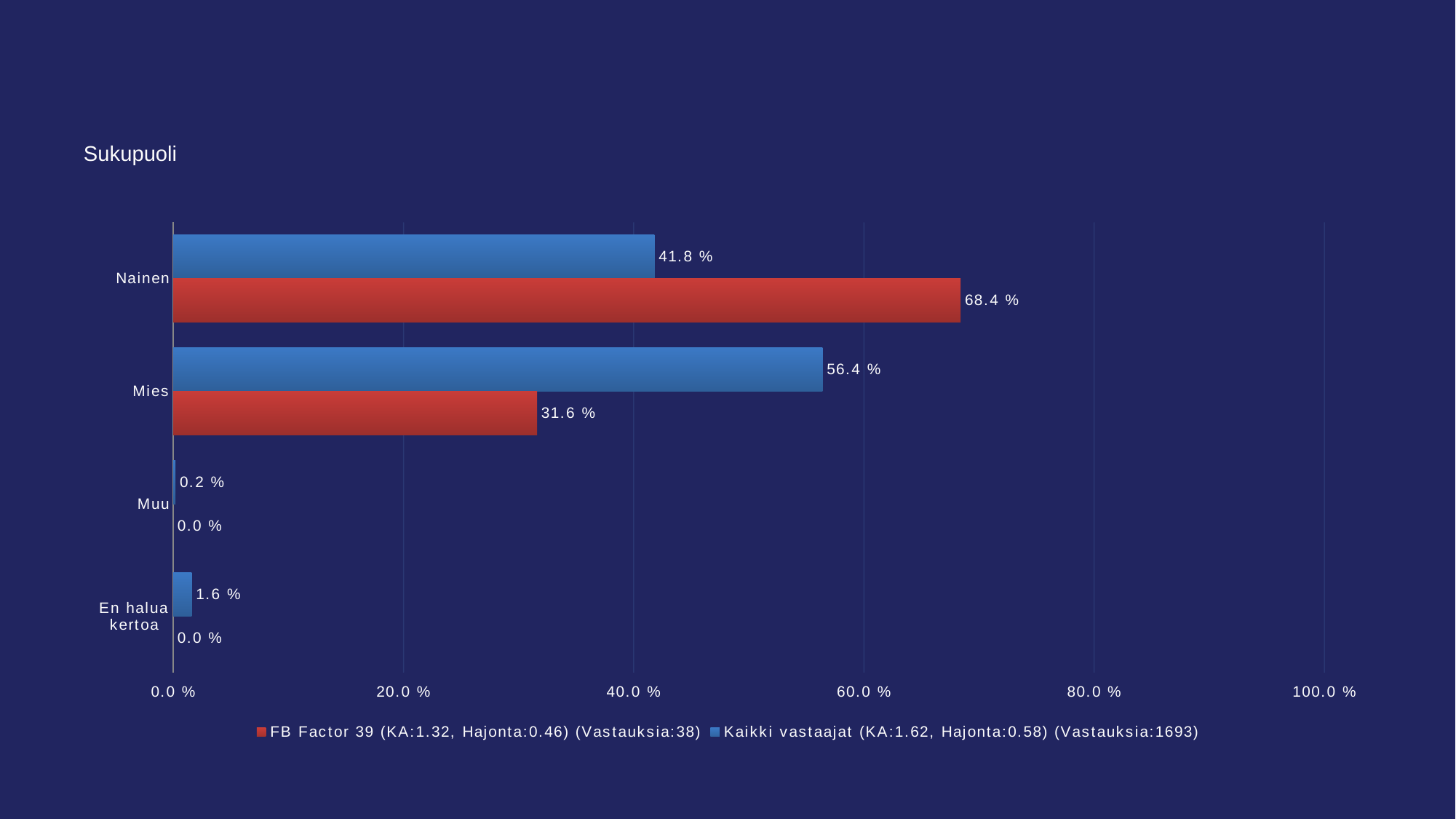
What is the value for En halua kertoa in the FB Factor 39 series? 0.0 % Which category has the lowest value in the Kaikki vastaajat series? Muu What is the value for Muu in the Kaikki vastaajat series? 0.2 % Which category has the highest value in the FB Factor 39 series? Nainen For Mies, which series has the larger value, FB Factor 39 or Kaikki vastaajat? Kaikki vastaajat How many categories are shown on the chart? 4 How many series does the legend list? 2 What is the difference between the FB Factor 39 and Kaikki vastaajat values for Nainen? 26.6 % What kind of chart is shown on the slide? Bar chart What is the value for Nainen in the FB Factor 39 series? 68.4 % Is the Kaikki vastaajat value for Nainen greater or less than 40.0 %? greater What is the value for Mies in the Kaikki vastaajat series? 56.4 %